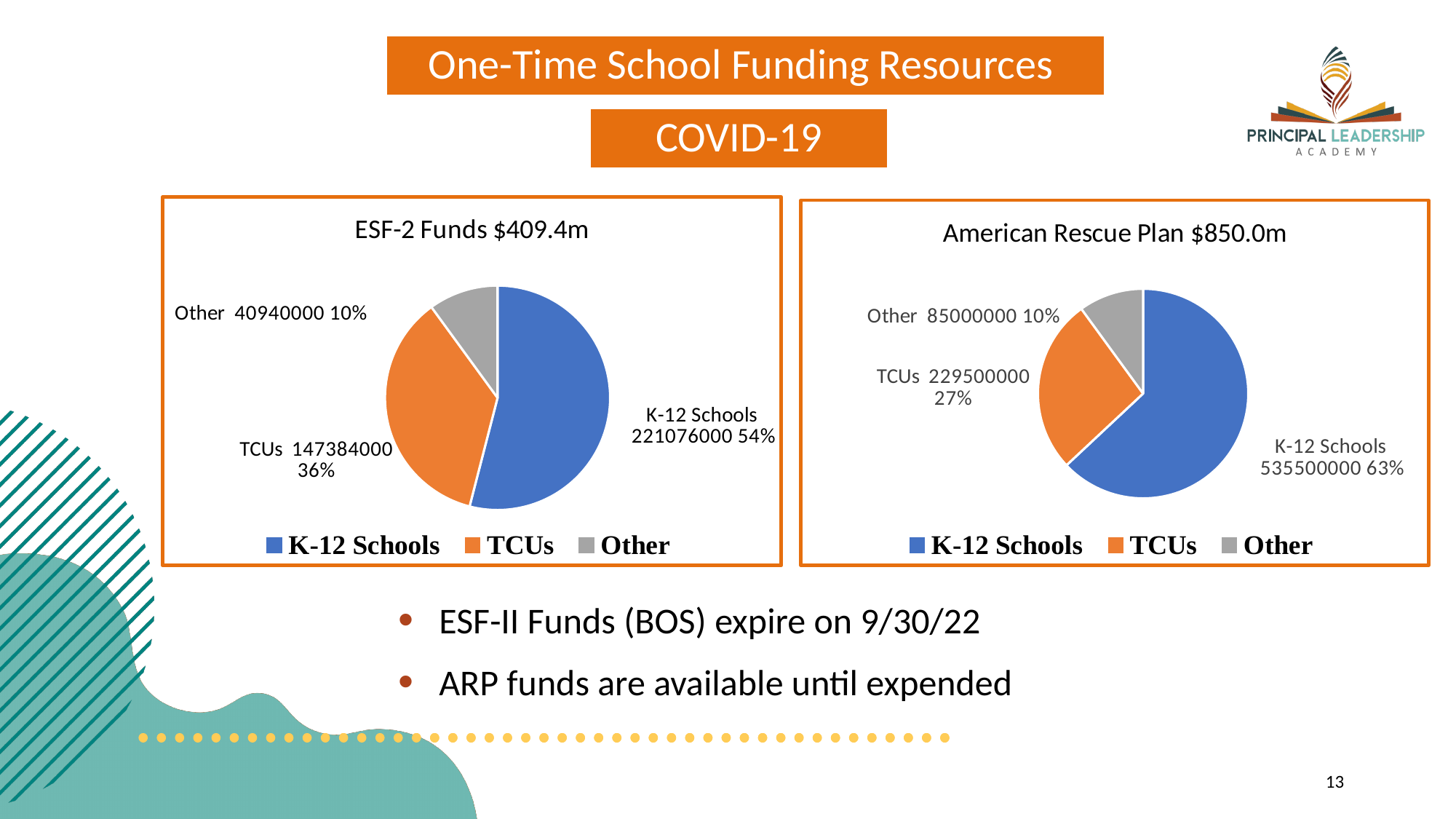
In the ESF-2 Funds $409.4m chart, what value is shown for TCUs? 147384000 In the American Rescue Plan $850.0m chart, what colour is the TCUs slice? Orange In the ESF-2 Funds $409.4m chart, which is larger, the value for TCUs or the value for Other? TCUs In the ESF-2 Funds $409.4m chart, which category has the largest slice? K-12 Schools How many categories does the American Rescue Plan $850.0m chart show? 3 What type of chart is the ESF-2 Funds $409.4m chart? Pie chart In the American Rescue Plan $850.0m chart, what value is shown for K-12 Schools? 535500000 In the American Rescue Plan $850.0m chart, what percentage share does TCUs have? 27% In the American Rescue Plan $850.0m chart, which category has the smallest slice? Other In the American Rescue Plan $850.0m chart, what is the difference between the K-12 Schools value and the TCUs value? 306000000 In the ESF-2 Funds $409.4m chart, what value is shown for Other? 40940000 In the ESF-2 Funds $409.4m chart, what percentage share does K-12 Schools have? 54%